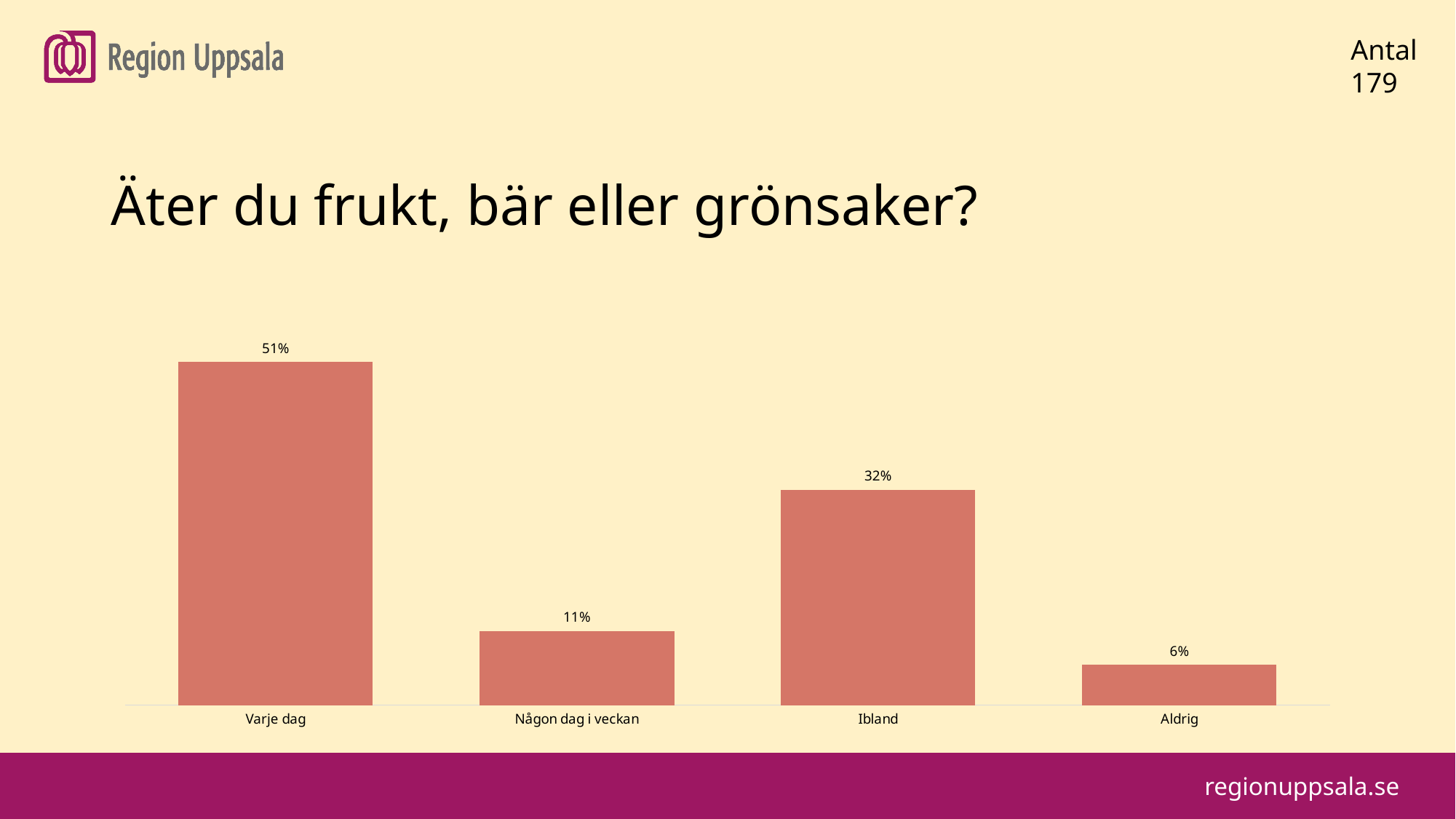
What is the value for Varje dag? 51% What is the value for Aldrig? 6% What is the difference between the values for Varje dag and Ibland? 19% What is the difference between the values for Någon dag i veckan and Aldrig? 5% Which category has the lowest value? Aldrig What is the value for Ibland? 32% What kind of chart is shown on the slide? Bar chart What is the title of the chart? Äter du frukt, bär eller grönsaker? What is the value for Någon dag i veckan? 11% Which category has the highest value? Varje dag Which is larger, the value for Ibland or the value for Någon dag i veckan? Ibland How many categories are shown in the chart? 4